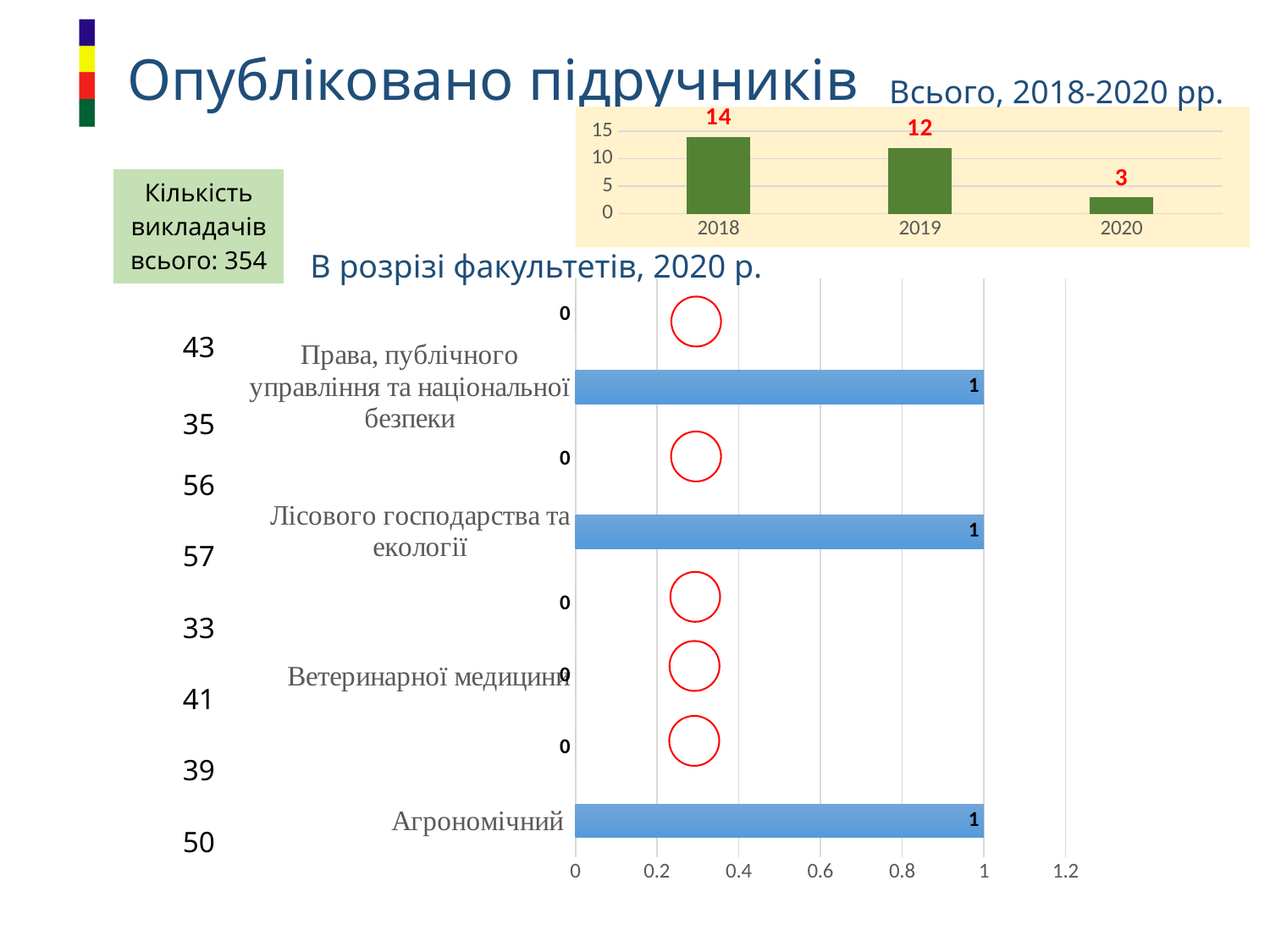
What kind of chart is the chart titled 'В розрізі факультетів, 2020 р.'? bar chart In the chart titled 'В розрізі факультетів, 2020 р.', which is larger: the value for Лісового господарства та екології or the value for Ветеринарної медицини? Лісового господарства та екології In the chart titled 'В розрізі факультетів, 2020 р.', what is the value for Агрономічний? 1 In the chart titled 'В розрізі факультетів, 2020 р.', how many bars have a value of 1? 3 In the chart titled 'Всього, 2018-2020 рр.', what is the value for 2018? 14 In the chart titled 'Всього, 2018-2020 рр.', do the values rise or fall from 2018 to 2020? fall In the chart titled 'Всього, 2018-2020 рр.', what is the difference between the values for 2018 and 2019? 2 In the chart titled 'Всього, 2018-2020 рр.', which year has the lowest value? 2020 In the chart titled 'Всього, 2018-2020 рр.', how many years are shown? 3 In the chart titled 'В розрізі факультетів, 2020 р.', what is the value for Ветеринарної медицини? 0 In the chart titled 'Всього, 2018-2020 рр.', which year has the highest value? 2018 In the chart titled 'Всього, 2018-2020 рр.', what is the value for 2020? 3